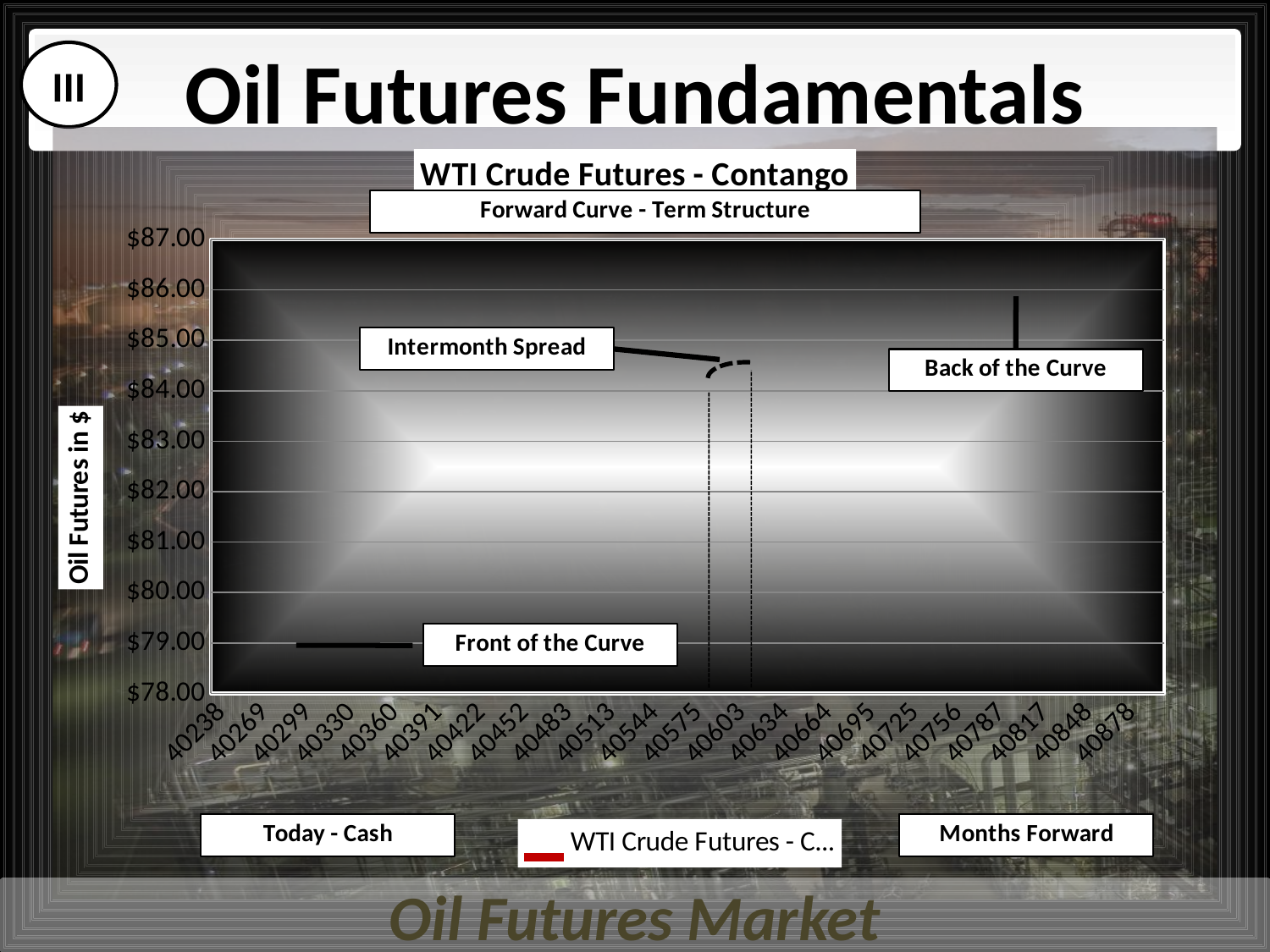
What kind of chart is shown on the slide? line chart What is the title of the chart on the slide? WTI Crude Futures - Contango What is the lowest value shown on the vertical axis of the chart? $78.00 How many category labels are shown along the x axis of the chart? 22 How many series does the chart's legend list? 1 What is the first category label on the x axis of the chart? 40238 What is the label of the vertical axis of the chart? Oil Futures in $ What is the highest value shown on the vertical axis of the chart? $87.00 What is the last category label on the x axis of the chart? 40878